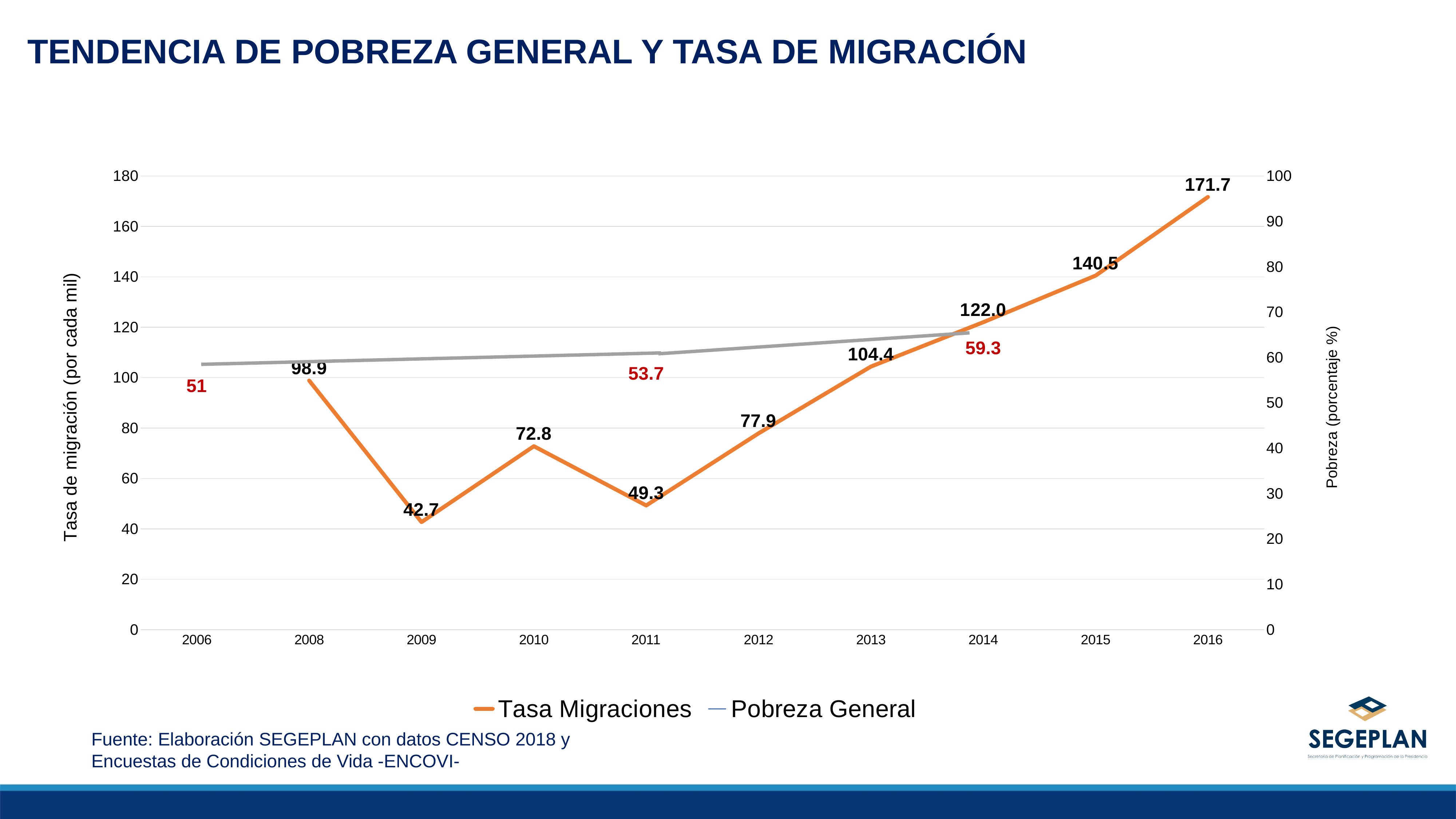
How many years are shown on the x axis? 10 Does the Tasa Migraciones rise or fall from 2011 to 2016? Rise Which is larger, the Tasa Migraciones value for 2010 or for 2011? 2010 In which year is the Tasa Migraciones highest? 2016 What is the Pobreza General value for 2006? 51 What is the Tasa Migraciones value for 2009? 42.7 What is the Tasa Migraciones value for 2016? 171.7 In which year is the Tasa Migraciones lowest? 2009 What kind of chart is shown on the slide? Line chart How many series does the legend list? 2 What is the Pobreza General value for 2011? 53.7 What is the difference between the Tasa Migraciones values for 2016 and 2015? 31.2